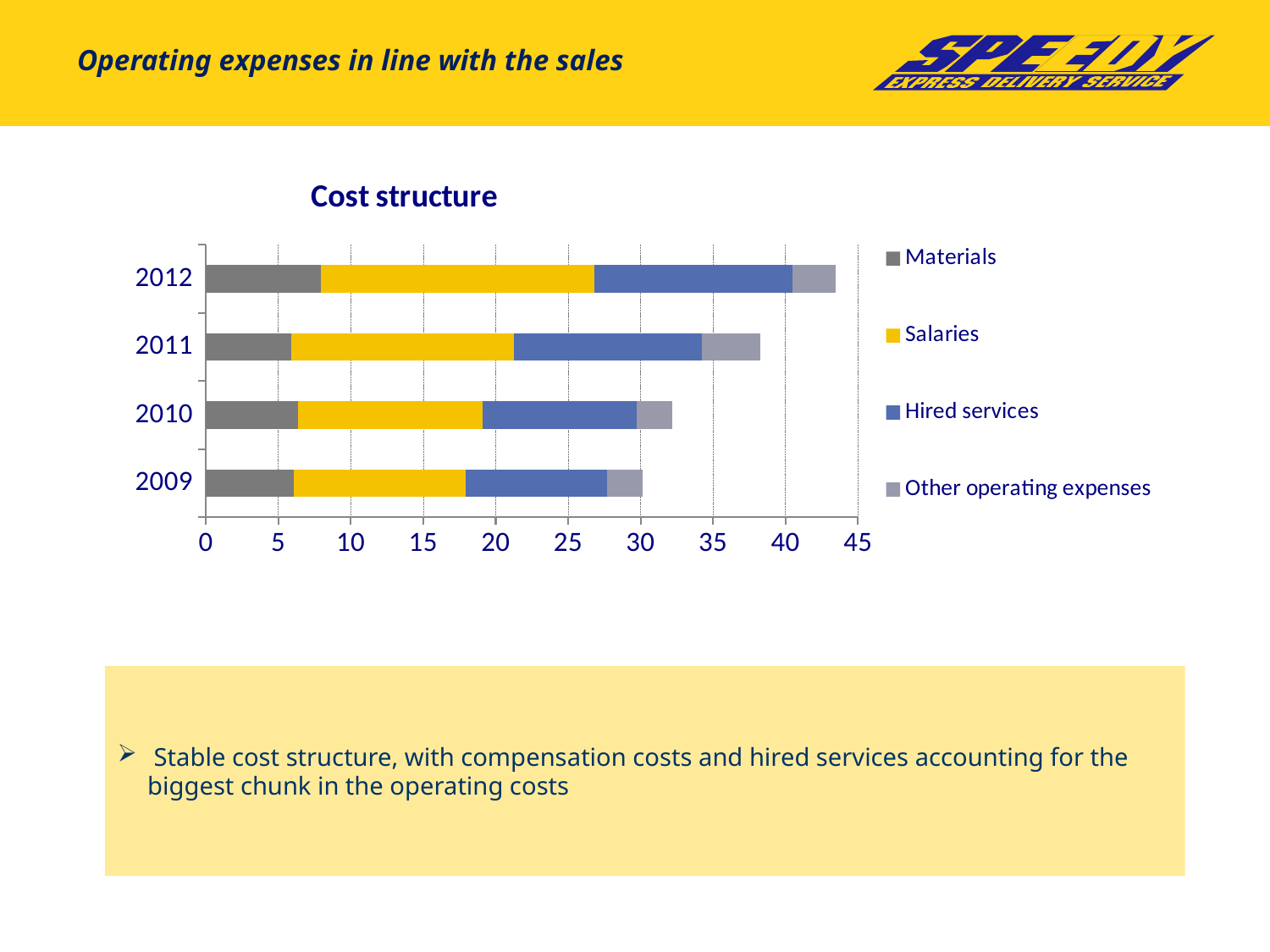
Do the total bar lengths rise or fall from 2009 to 2012? Rise Is the total bar for 2012 greater or less than 40? greater What is the title of the chart? Cost structure How many years are shown on the chart? 4 What kind of chart is shown on the slide? Stacked bar chart How many series does the legend list? 4 Which colour represents Salaries in the chart? Yellow Is the total bar for 2009 greater or less than 35? less Which year has the longest total bar? 2012 Which year has the shortest total bar? 2009 Is the total bar for 2011 greater or less than 35? greater Which series has the largest segment in the 2012 bar? Salaries